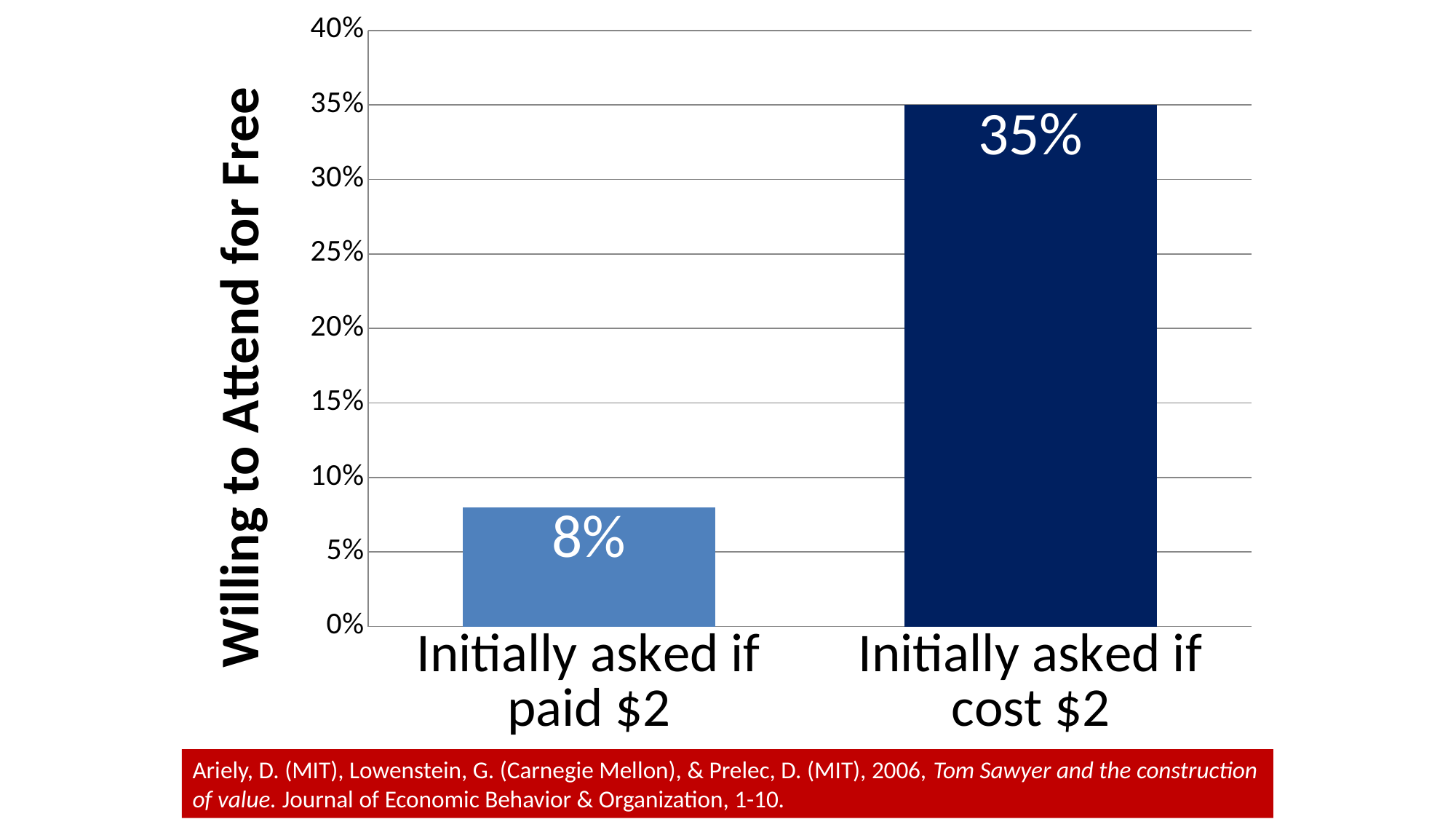
What percentage were willing to attend for free when initially asked if paid $2? 8% Is the value for 'Initially asked if paid $2' greater or less than 10%? less What is the label of the vertical axis? Willing to Attend for Free Which category has the lowest value? Initially asked if paid $2 Which category has the highest value? Initially asked if cost $2 What is the difference between the 'Initially asked if cost $2' and 'Initially asked if paid $2' values? 27% How many categories are shown on the chart? 2 What kind of chart is shown on the slide? Bar chart What percentage were willing to attend for free when initially asked if cost $2? 35% Which is larger: the value for 'Initially asked if paid $2' or 'Initially asked if cost $2'? Initially asked if cost $2 Is the value for 'Initially asked if cost $2' greater or less than 30%? greater What is the maximum value shown on the vertical axis? 40%